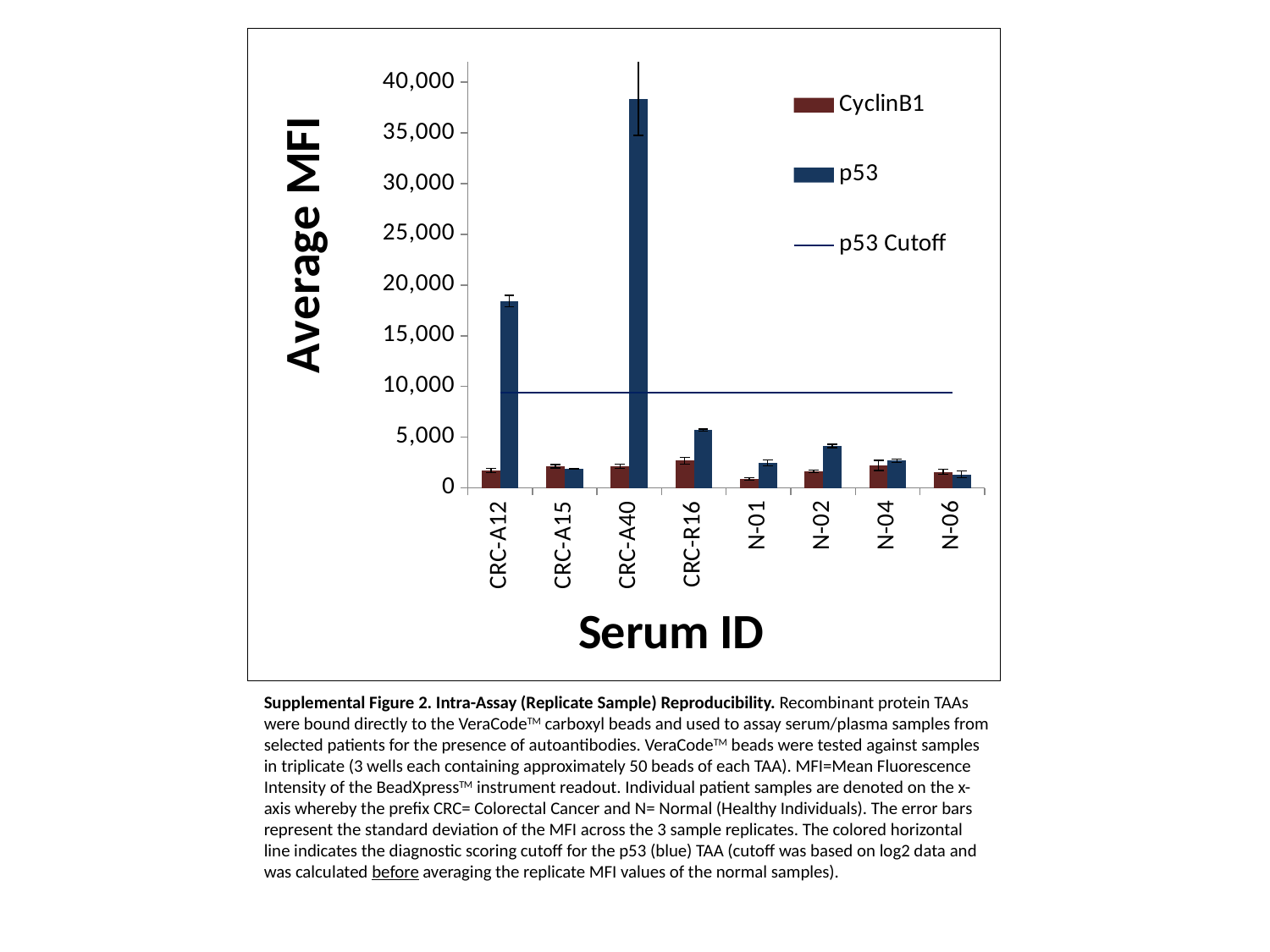
How many entries does the chart's legend list? 3 Which serum ID has the highest p53 value? CRC-A40 What is the label of the chart's x axis? Serum ID What is the label of the chart's y axis? Average MFI How many serum IDs are shown on the x axis of the chart? 8 Is the p53 value for CRC-A40 greater or less than 35,000? greater Which serum ID has the lowest CyclinB1 value? N-01 Is the p53 value for CRC-A12 greater or less than 20,000? less Is the p53 value for CRC-A12 greater or less than 15,000? greater For CRC-A12, which is larger, the CyclinB1 value or the p53 value? p53 What kind of chart is shown on the slide? bar chart